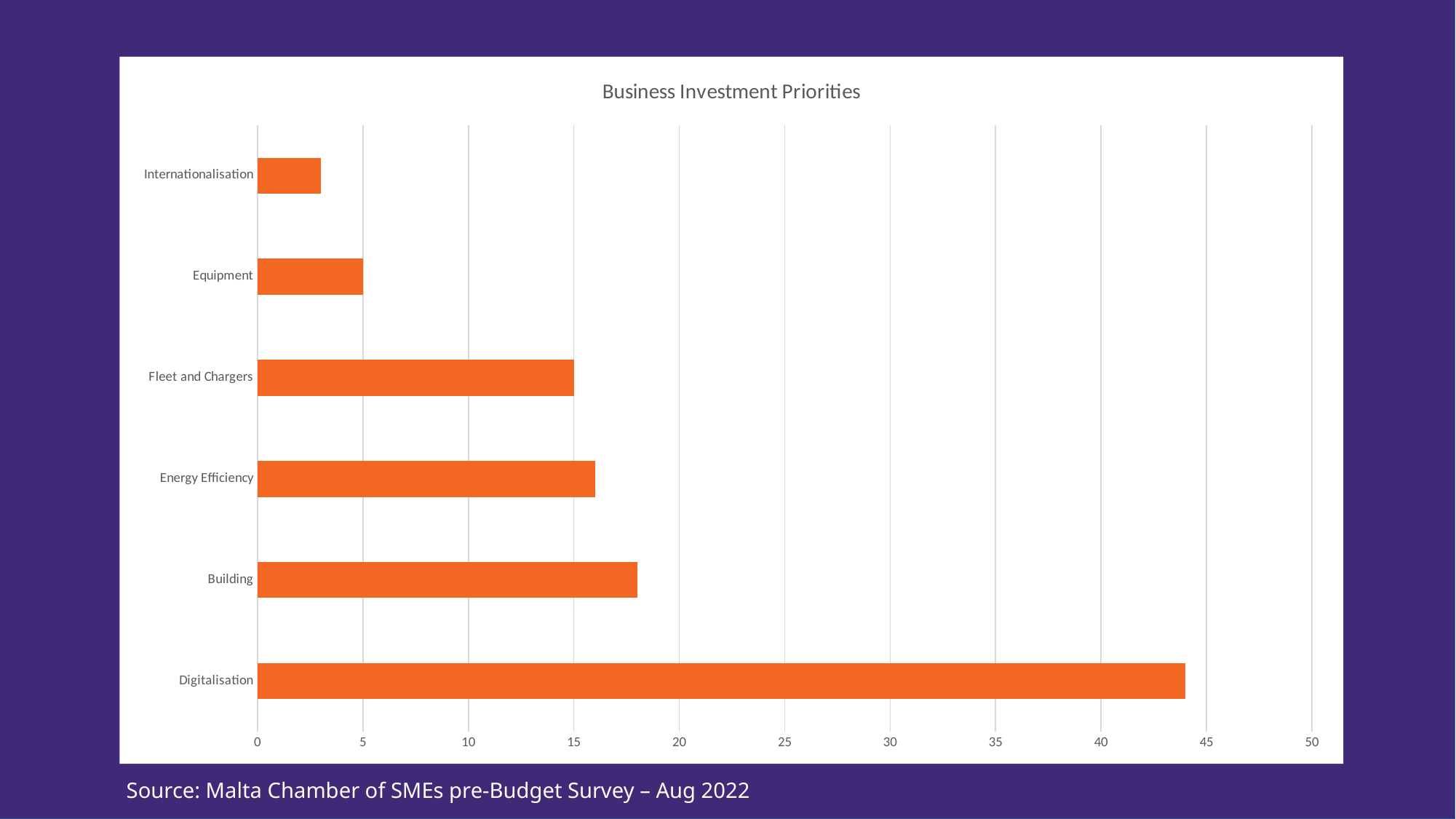
Which category has the highest value? Digitalisation Is the value for Building greater or less than 20? less What is the value for Equipment? 5 What is the value for Fleet and Chargers? 15 Which has a larger value, Building or Energy Efficiency? Building What is the difference between the values for Fleet and Chargers and Equipment? 10 Is the value for Digitalisation greater or less than 40? greater Is the value for Internationalisation greater or less than 5? less Which category has the lowest value? Internationalisation What type of chart is shown on the slide? Bar chart What is the title of the chart? Business Investment Priorities How many categories are plotted in the chart? 6